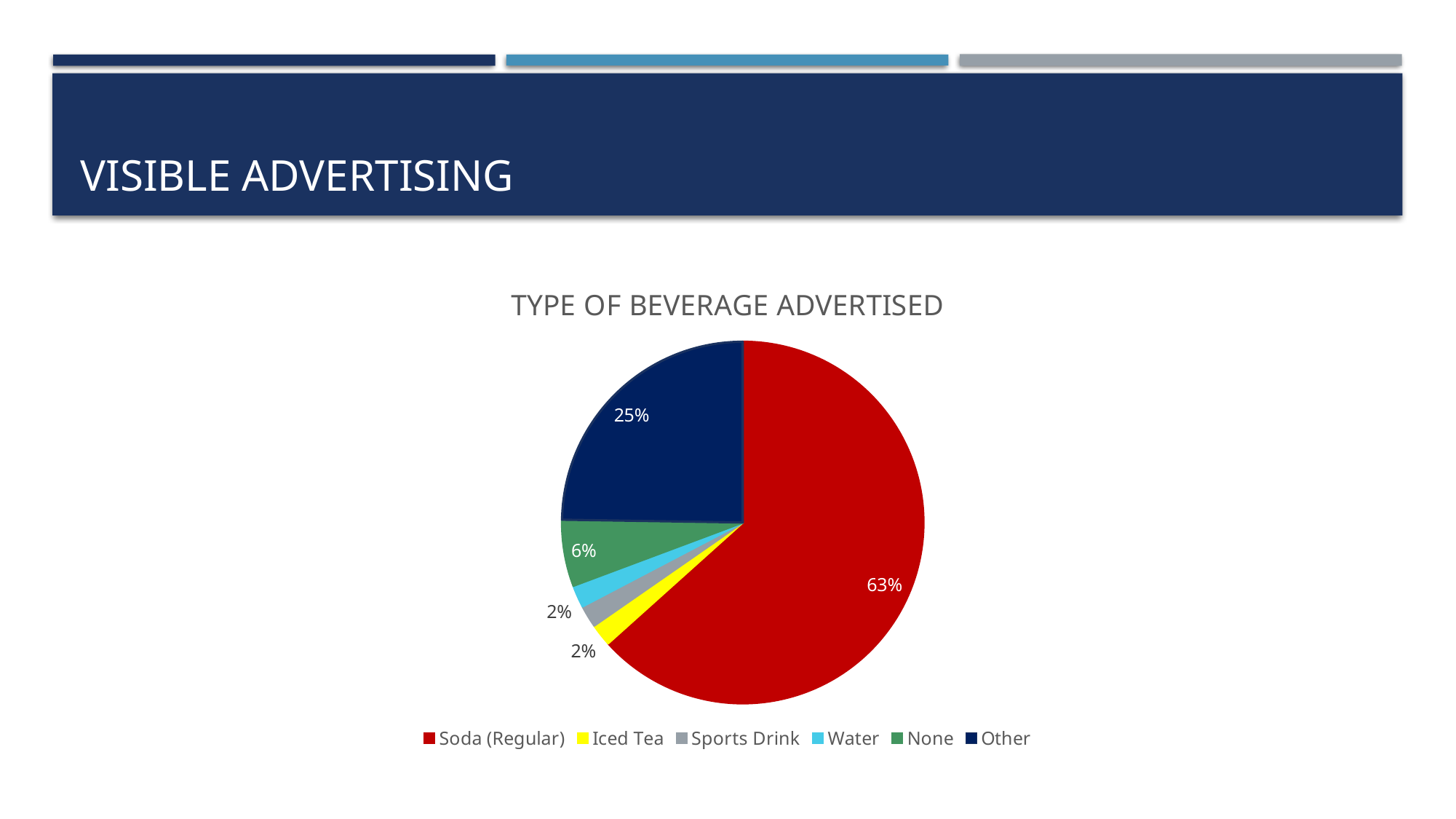
How many categories does the legend list? 6 What percentage is shown for the None slice? 6% What is the title of the chart? Type of Beverage Advertised What colour is the Soda (Regular) slice? Red What percentage of the pie does Soda (Regular) account for? 63% How many percentage points larger is the Soda (Regular) share than the Other share? 38 percentage points What kind of chart is shown on the slide? Pie chart What percentage of the pie is labelled for the Other category? 25% What percentage is shown for the Iced Tea slice? 2% Which type of beverage has the largest share of the pie? Soda (Regular) What share of the pie does the Other slice represent? 25% Which slice is larger, Other or None? Other